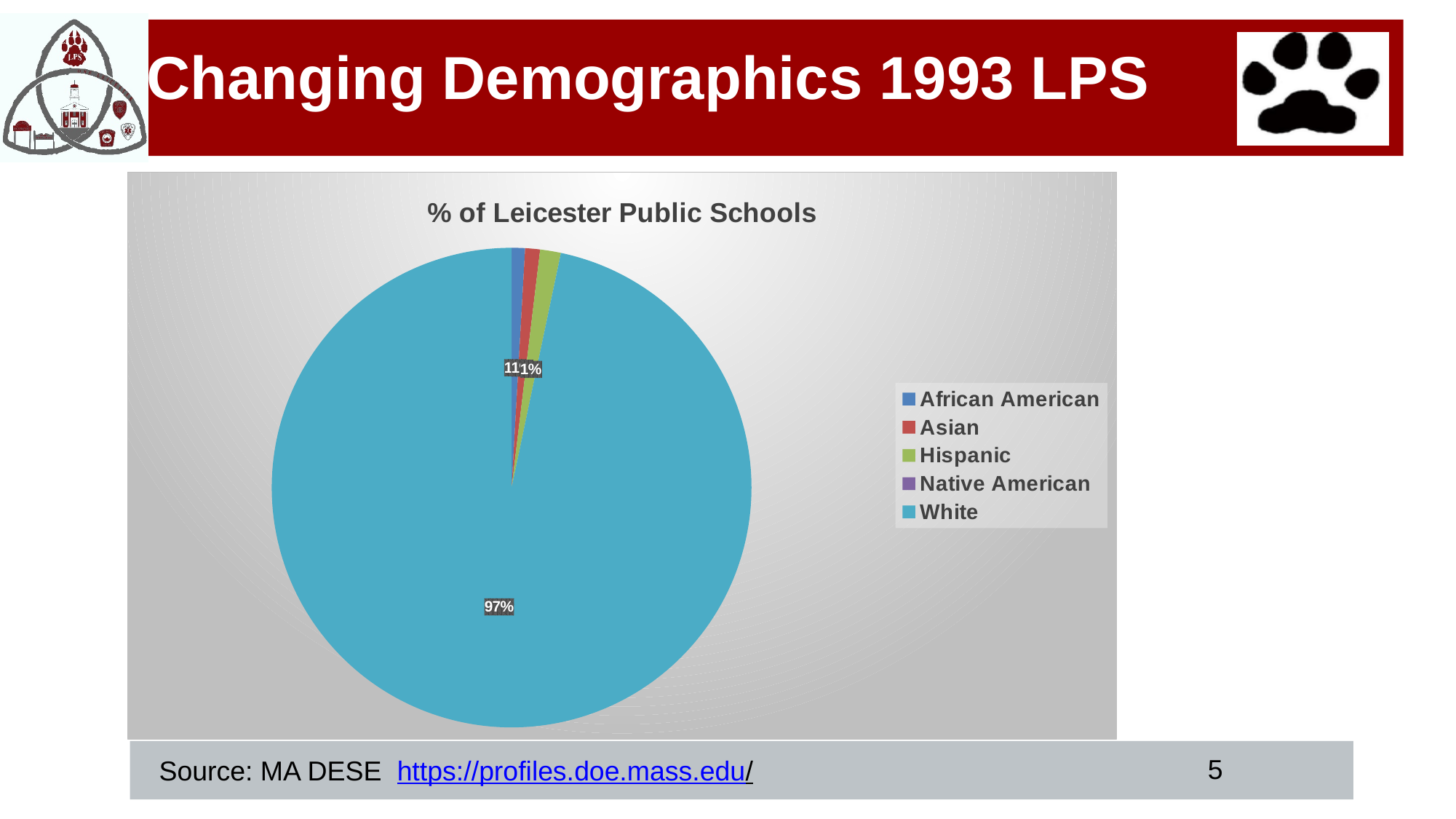
Which is larger, the White slice or the Hispanic slice? White What kind of chart is shown on the slide? pie chart What percentage is shown for the White slice? 97% Which is larger, the Asian slice or the White slice? White How many categories does the chart's legend list? 5 Is the value for White greater or less than 50%? greater Which category has the largest slice of the pie? White Is the value for African American greater or less than 10%? less Which category is shown in green in the legend? Hispanic What share of the pie does the White category make up? 97% What is the title of the chart? % of Leicester Public Schools